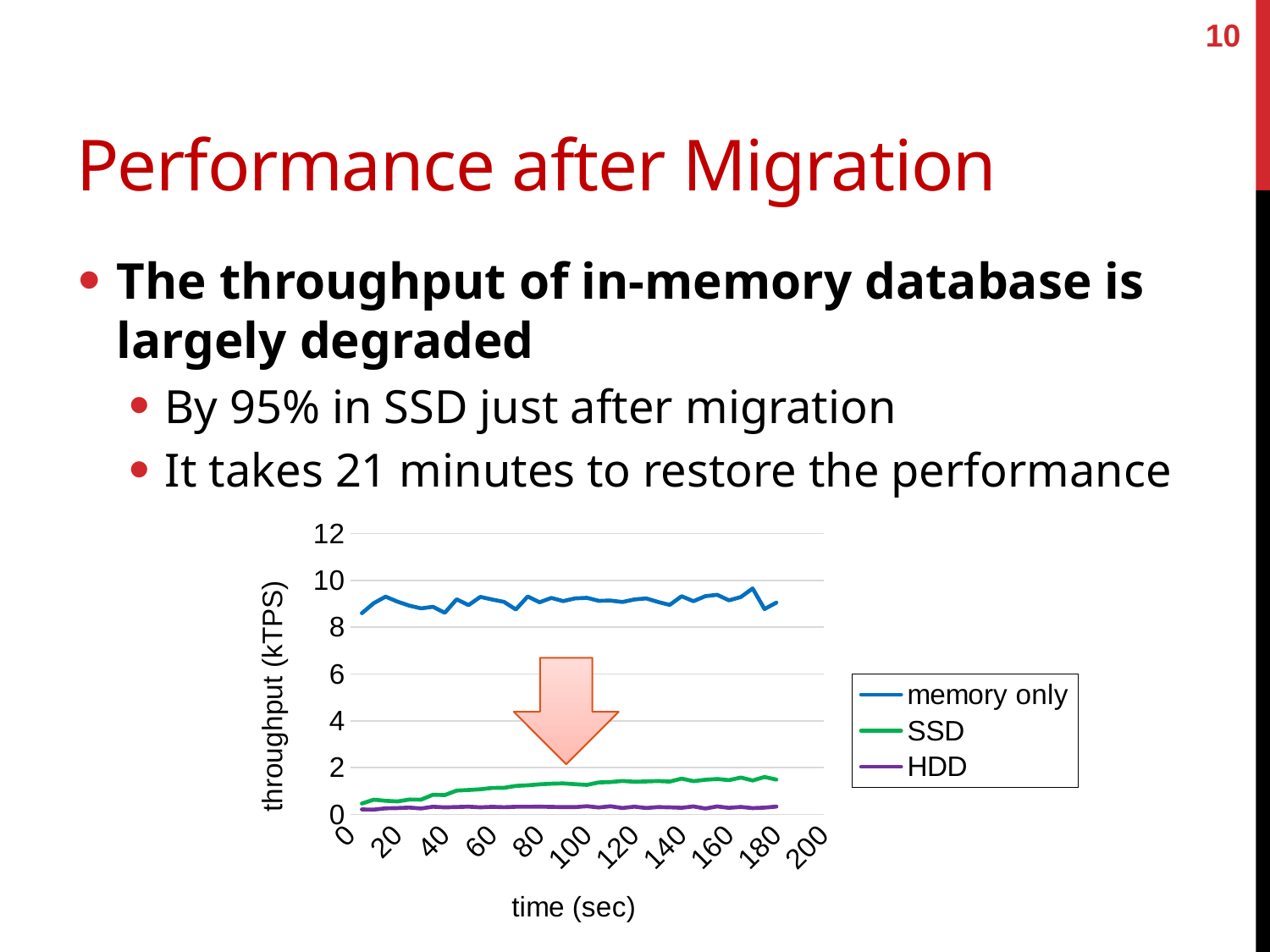
What kind of chart is shown on the slide? line chart Which series has the lowest throughput throughout the chart? HDD What is the label of the y axis? throughput (kTPS) Which series has the highest throughput throughout the chart? memory only Is the throughput of the HDD series greater or less than 2 kTPS? less How many series does the chart legend list? 3 What is the label of the x axis? time (sec) Does the SSD series rise or fall as time increases? rise Is the throughput of the memory only series greater or less than 10 kTPS? less Is the throughput of the memory only series greater or less than 8 kTPS? greater Which series has higher throughput, SSD or HDD? SSD